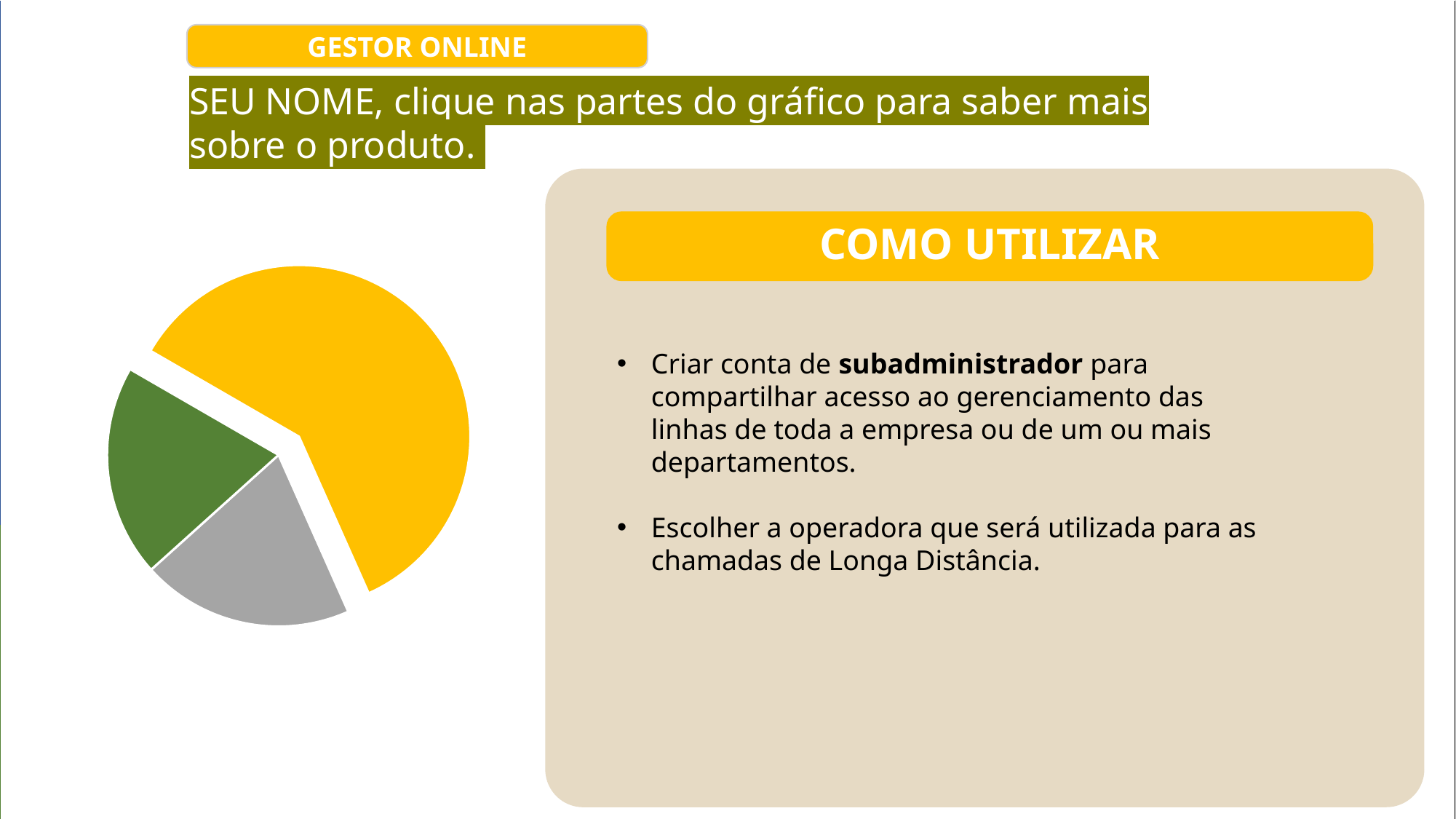
Does the pie chart display a legend? No What colours are the slices of the pie chart? Yellow, green and gray What kind of chart is shown on the left of the slide? Pie chart Is the yellow slice or the green slice of the pie chart larger? The yellow slice Does the yellow slice take up more or less than half of the pie chart? More How many slices does the pie chart have? 3 Is the yellow slice or the gray slice of the pie chart larger? The yellow slice Which slice of the pie chart is the largest? The yellow slice